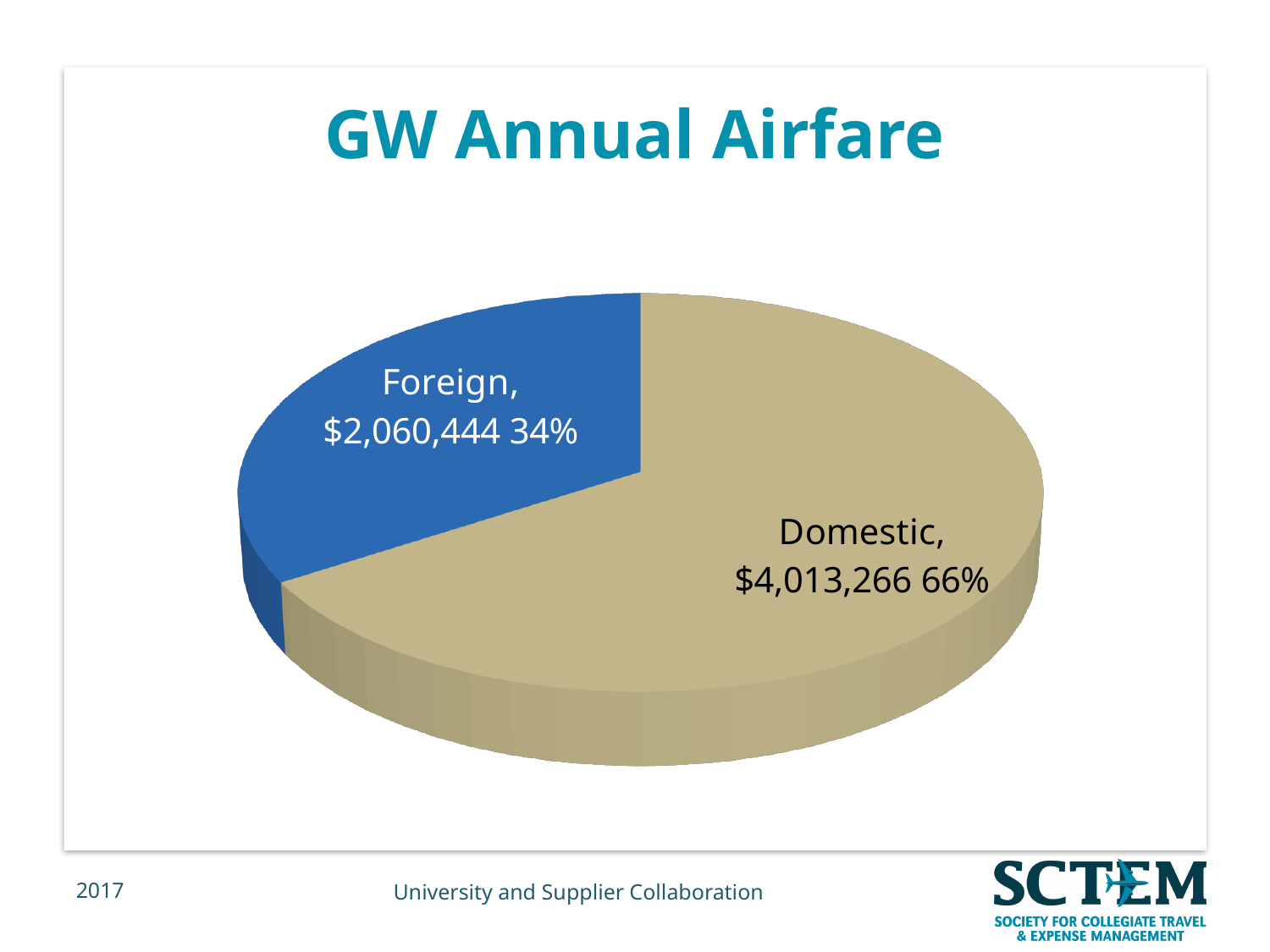
What is the airfare value for Domestic? $4,013,266 How many slices does the pie chart have? 2 What is the difference between the Domestic and Foreign airfare values? $1,952,822 Which is larger, the Domestic or the Foreign airfare? Domestic What colour is the Foreign slice? Blue What is the airfare value for Foreign? $2,060,444 What kind of chart is shown on the slide? Pie chart Which category has the smallest slice? Foreign Which category has the largest slice? Domestic What is the title of the chart? GW Annual Airfare What share of the pie does the Domestic slice represent? 66% What share of the pie does the Foreign slice represent? 34%